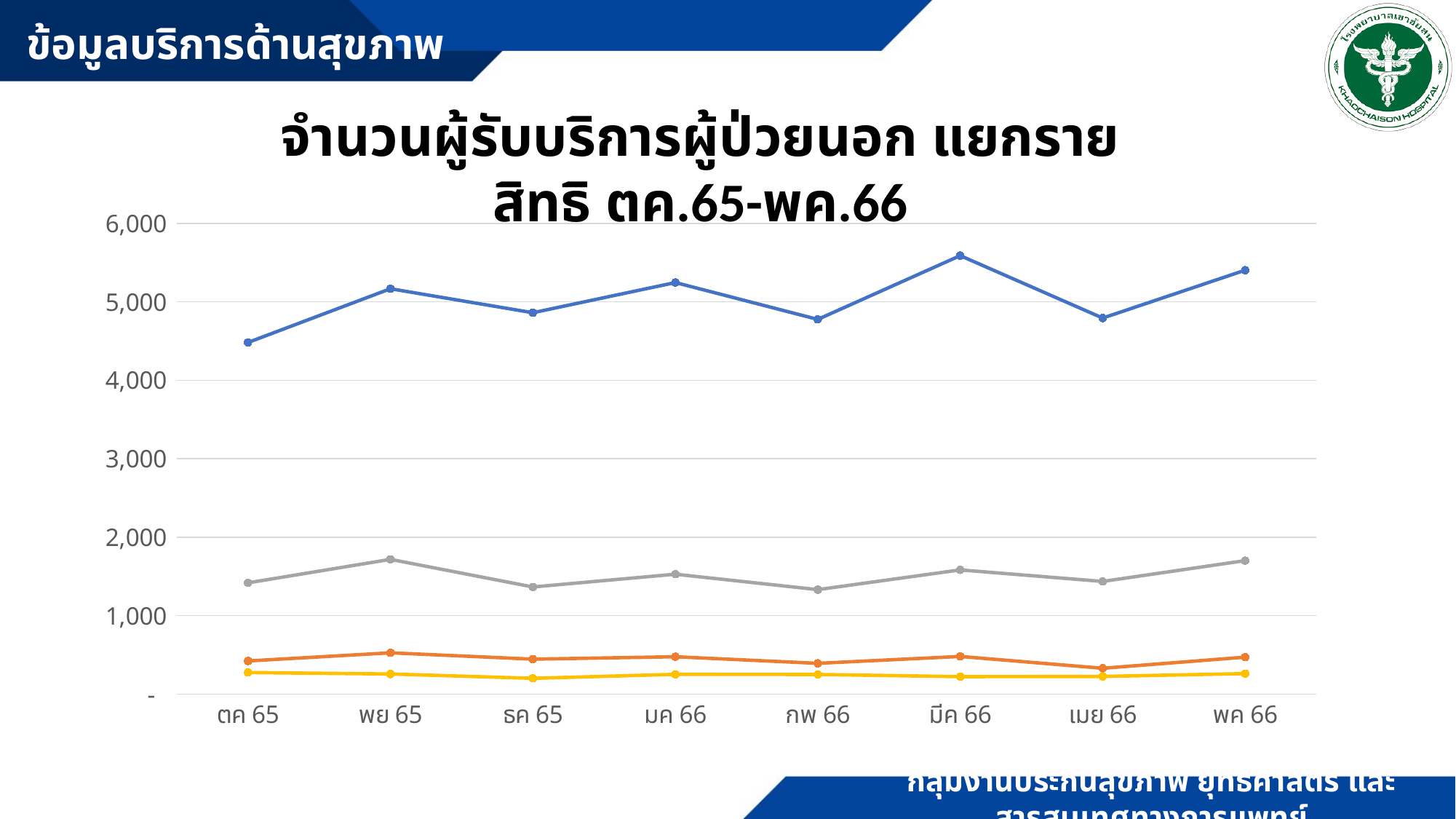
What is the title of the chart? จำนวนผู้รับบริการผู้ป่วยนอก แยกรายสิทธิ ตค.65-พค.66 Is the value of the orange line at พย 65 greater or less than 1,000? less Is the value of the blue line at ตค 65 greater or less than 5,000? less At พย 65, which is larger: the orange line or the yellow line? orange line At which month does the blue line reach its lowest value? ตค 65 Which colour line has the highest values throughout the chart? blue What kind of chart is shown on the slide? line chart Is the value of the gray line at พย 65 greater or less than 2,000? less At which month does the blue line reach its highest value? มีค 66 How many lines are plotted on the chart? 4 How many months (points) are plotted along the x axis? 8